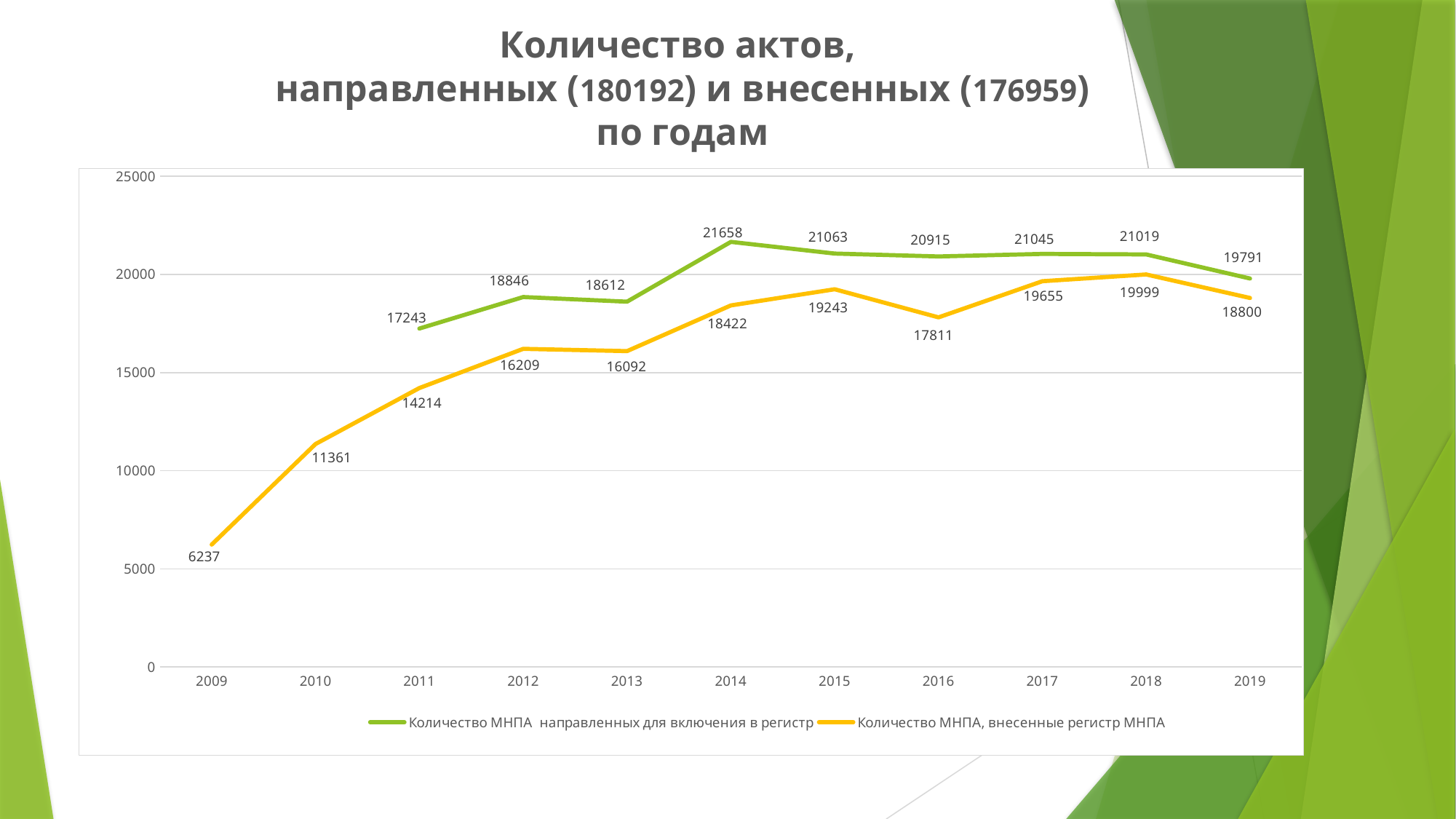
What is the value of the series 'Количество МНПА, внесенные регистр МНПА' for 2009? 6237 How many series does the legend list? 2 What is the value of the series 'Количество МНПА направленных для включения в регистр' for 2014? 21658 What is the difference between the two series' values in 2019? 991 Does the series 'Количество МНПА, внесенные регистр МНПА' rise or fall from 2009 to 2012? Rise In which year does the series 'Количество МНПА направленных для включения в регистр' reach its highest value? 2014 What colour is the line for 'Количество МНПА, внесенные регистр МНПА'? Yellow Which series has the larger value in 2016? Количество МНПА направленных для включения в регистр How many years are shown on the x axis? 11 In which year does the series 'Количество МНПА, внесенные регистр МНПА' have its lowest value? 2009 What type of chart is shown on the slide? Line chart What is the value of the series 'Количество МНПА, внесенные регистр МНПА' for 2018? 19999